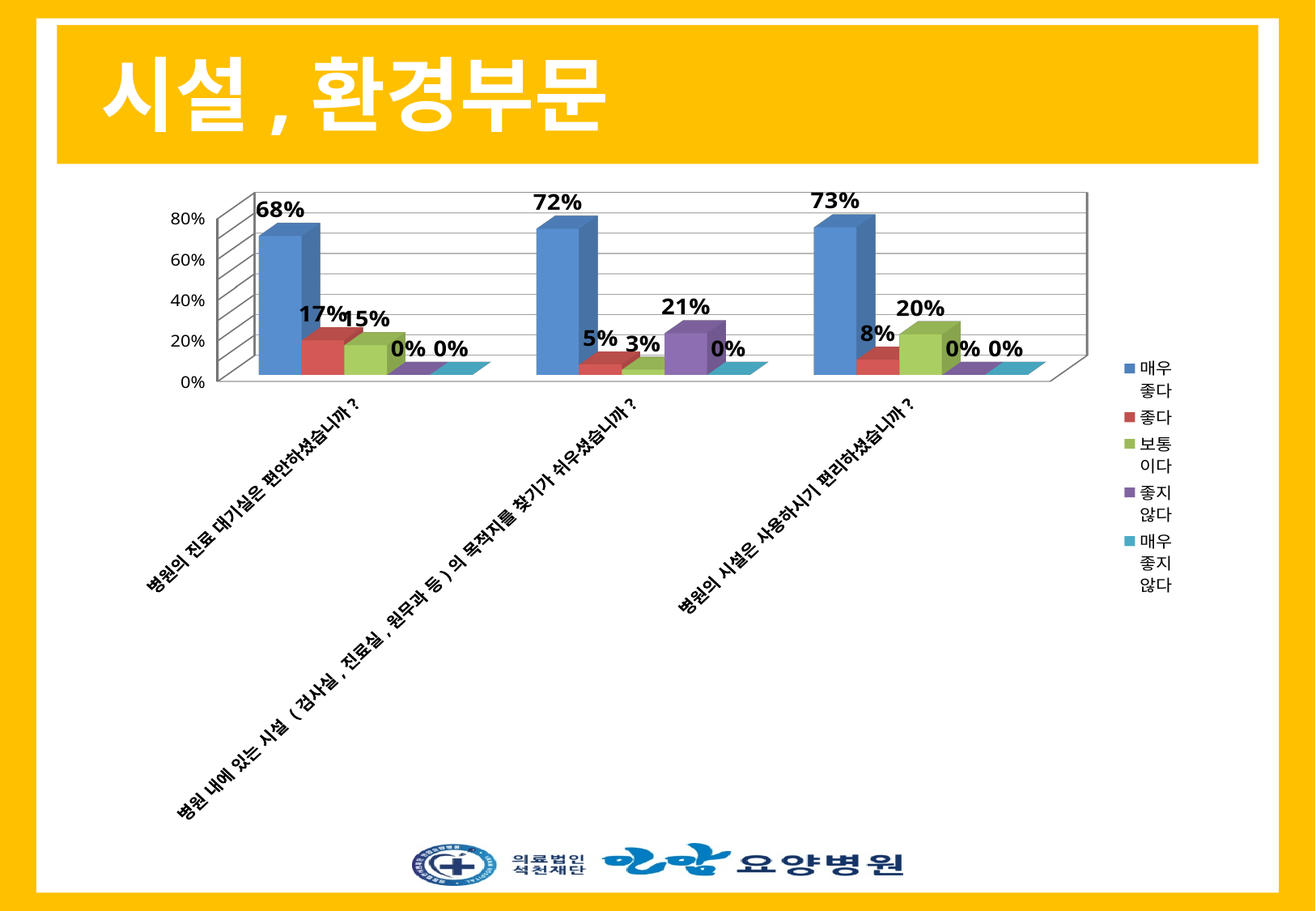
For the question 병원의 진료 대기실은 편안하셨습니까?, which is larger: 좋다 or 보통이다? 좋다 Is the 매우 좋다 value for 병원 내에 있는 시설의 목적지를 찾기가 쉬우셨습니까? greater or less than 60%? greater What is the value for 보통이다 for the question 병원의 시설은 사용하시기 편리하셨습니까? 20% What is the difference between the 매우 좋다 values for 병원의 시설은 사용하시기 편리하셨습니까? and 병원의 진료 대기실은 편안하셨습니까? 5% How many series does the legend list? 5 What is the value for 좋지 않다 for the question about finding destinations within the hospital facilities (병원 내에 있는 시설의 목적지를 찾기가 쉬우셨습니까?)? 21% What is the value for 매우 좋다 for the question 병원의 진료 대기실은 편안하셨습니까? 68% What kind of chart is shown on the slide? bar chart Which question has the highest 매우 좋다 value? 병원의 시설은 사용하시기 편리하셨습니까? What is the value for 좋다 for the question 병원의 시설은 사용하시기 편리하셨습니까? 8% Which question has the lowest 좋다 value? 병원 내에 있는 시설(검사실, 진료실, 원무과 등)의 목적지를 찾기가 쉬우셨습니까? How many questions (categories) are shown on the x axis of the chart? 3